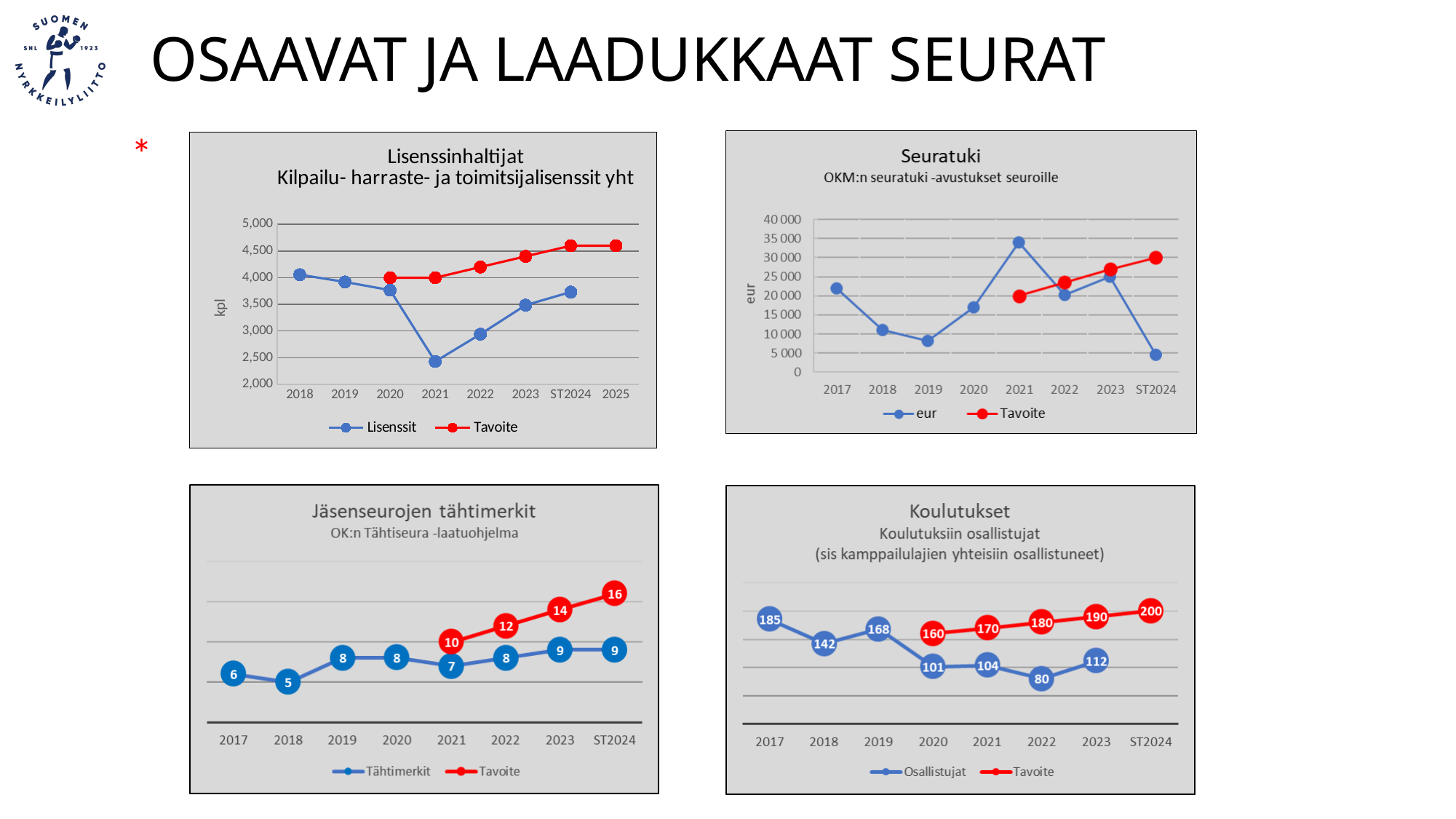
What kind of chart is the Lisenssinhaltijat chart? line chart In the Koulutukset chart, which year has the highest Osallistujat value? 2017 In the Koulutukset chart, what is the difference between Tavoite and Osallistujat in 2020? 59 In the Jäsenseurojen tähtimerkit chart, what is the difference between Tavoite and Tähtimerkit in 2022? 4 In the Seuratuki chart, which year has the highest eur value? 2021 In the Lisenssinhaltijat chart, is the Lisenssit value for 2021 greater or less than 2,500? less In the Jäsenseurojen tähtimerkit chart, what is the Tähtimerkit value for 2018? 5 In the Jäsenseurojen tähtimerkit chart, what is the Tavoite value for ST2024? 16 In the Koulutukset chart, what is the Osallistujat value for 2022? 80 In the Koulutukset chart, how many years are shown on the x axis? 8 In the Jäsenseurojen tähtimerkit chart, which year has the lowest Tähtimerkit value? 2018